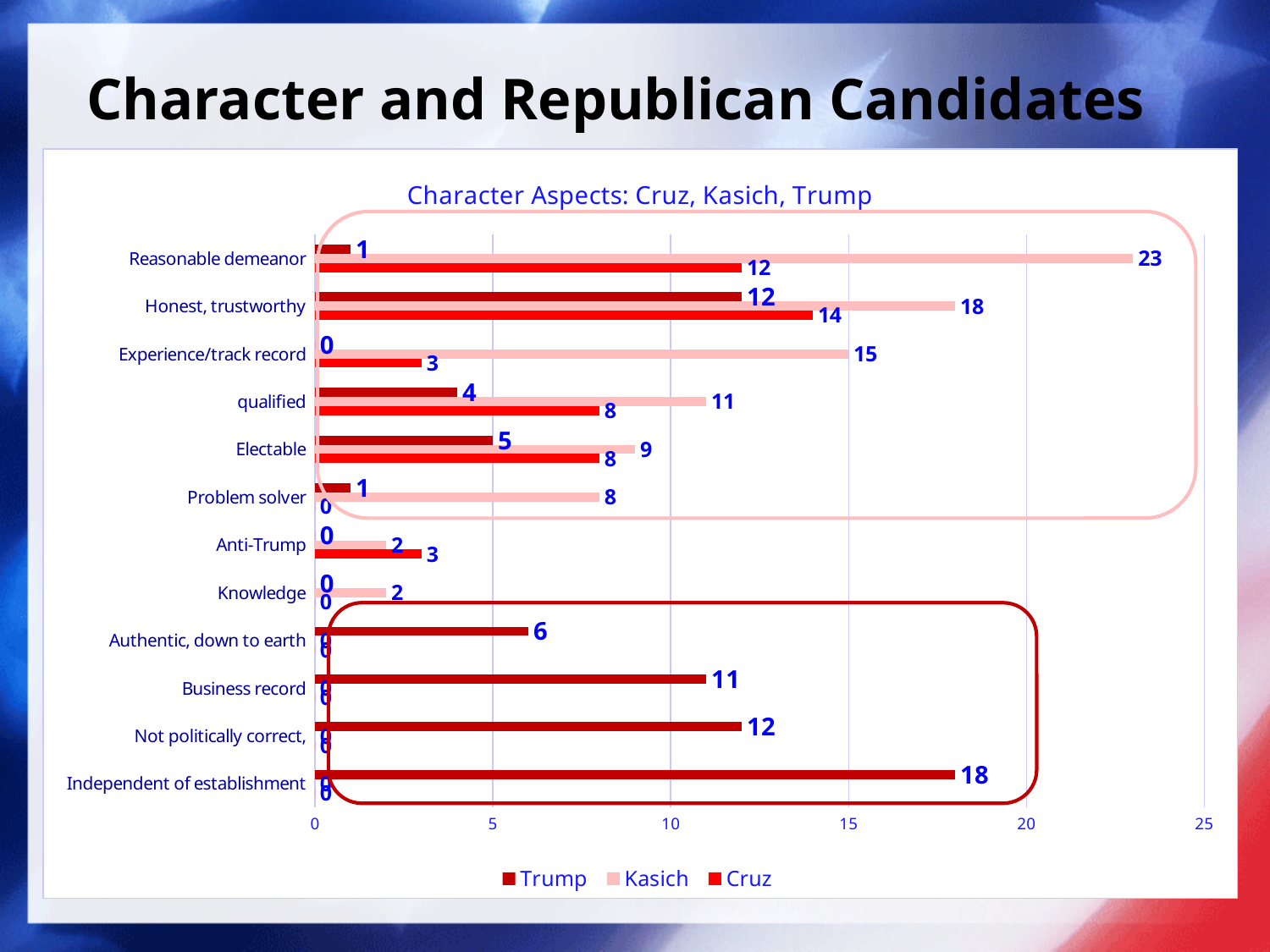
What is the value for Trump on 'Electable'? 5 What is the title of the chart? Character Aspects: Cruz, Kasich, Trump What kind of chart is shown on the slide? bar chart What is the difference between Kasich's and Cruz's values on 'Experience/track record'? 12 How many character aspects (categories) are plotted on the chart? 12 What is the value for Cruz on 'Honest, trustworthy'? 14 Which category has the highest value for Trump? Independent of establishment On 'qualified', which is larger: the value for Kasich or the value for Cruz? Kasich How many series does the legend list? 3 Which category has the highest value for Kasich? Reasonable demeanor What is the value for Trump on 'Independent of establishment'? 18 What is the value for Kasich on 'Reasonable demeanor'? 23